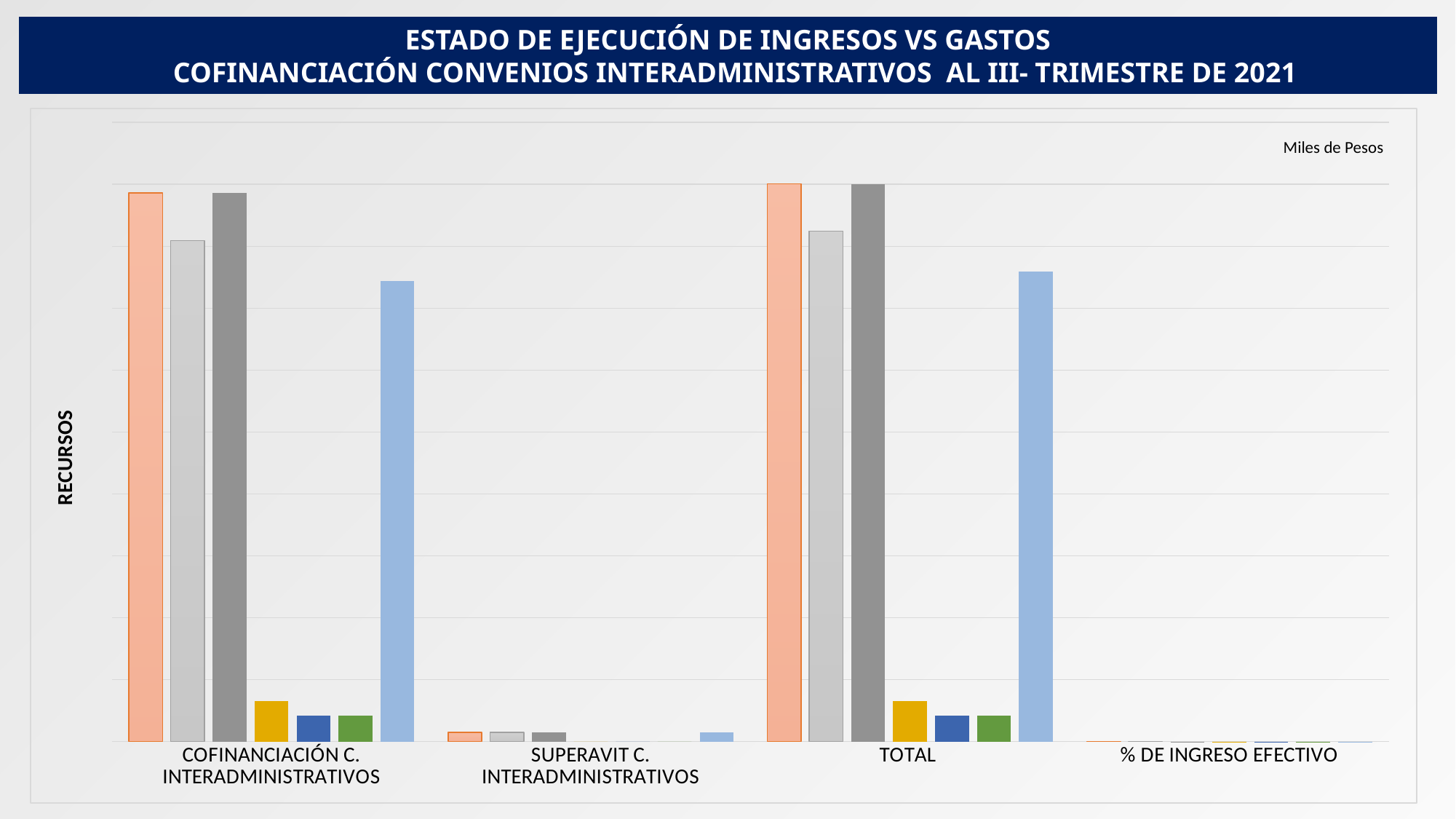
How many categories are shown along the x axis of the chart? 4 In what unit are the values of the chart expressed, according to the note in the top right of the plot area? Miles de Pesos What is the label on the vertical axis of the chart? RECURSOS Which category has larger values, TOTAL or % DE INGRESO EFECTIVO? TOTAL Which category has larger values, TOTAL or SUPERAVIT C. INTERADMINISTRATIVOS? TOTAL Which category has the lowest values in the chart? % DE INGRESO EFECTIVO What kind of chart is shown on the slide? Bar chart Which category has larger values, COFINANCIACIÓN C. INTERADMINISTRATIVOS or SUPERAVIT C. INTERADMINISTRATIVOS? COFINANCIACIÓN C. INTERADMINISTRATIVOS